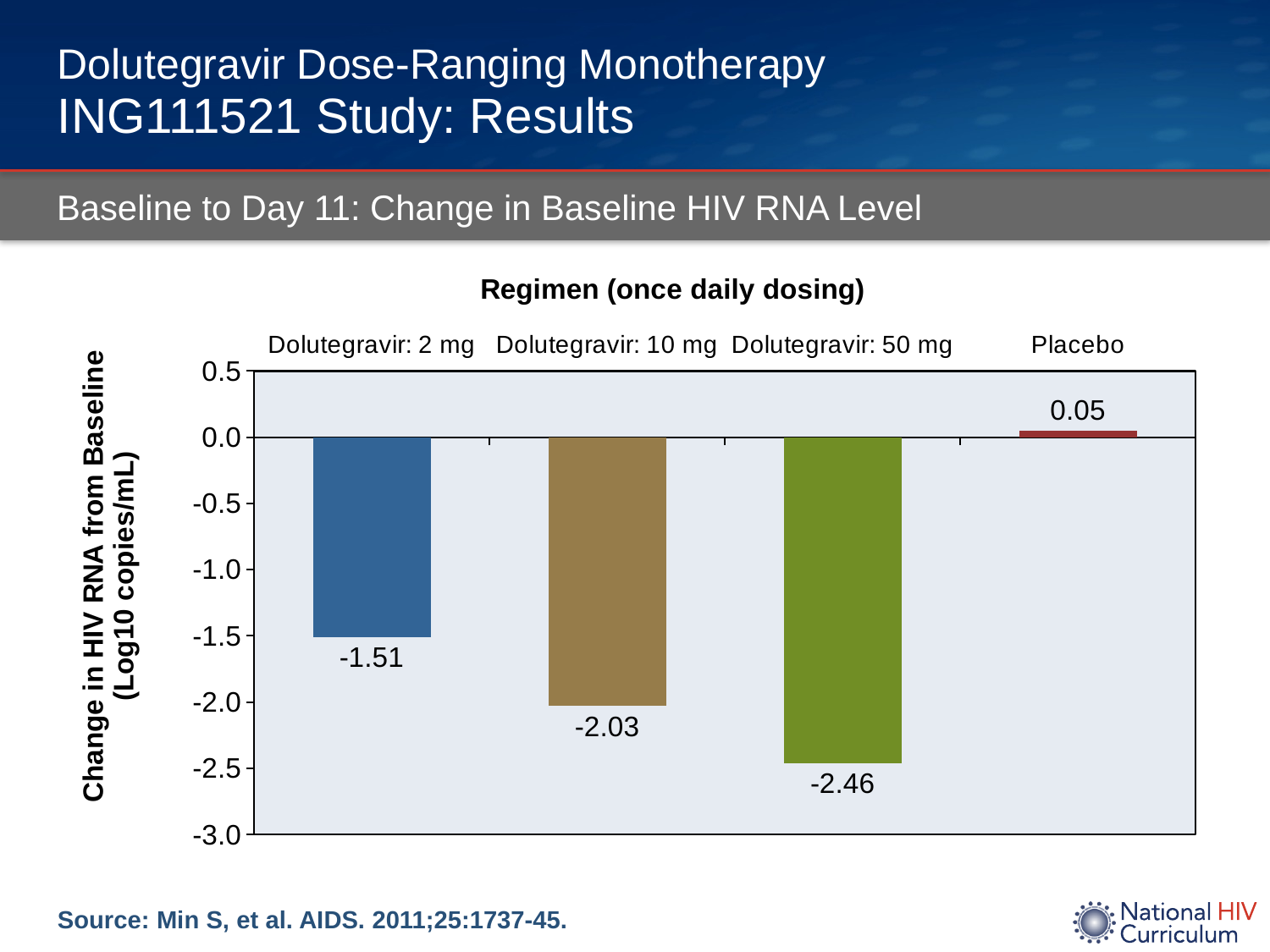
Which has a larger (less negative) value, Dolutegravir: 2 mg or Dolutegravir: 10 mg? Dolutegravir: 2 mg What is the difference between the values for Dolutegravir: 50 mg and Dolutegravir: 2 mg? 0.95 How many regimens are shown in the chart? 4 What is the change in HIV RNA from baseline for Dolutegravir: 10 mg? -2.03 What kind of chart is shown on the slide? Bar chart What is the change in HIV RNA from baseline for Dolutegravir: 50 mg? -2.46 What is the change in HIV RNA from baseline for Dolutegravir: 2 mg? -1.51 What is the label of the vertical axis of the chart? Change in HIV RNA from Baseline (Log10 copies/mL) Is the value for Dolutegravir: 10 mg greater or less than -1.5? less Which regimen has the lowest (most negative) change in HIV RNA from baseline? Dolutegravir: 50 mg What is the change in HIV RNA from baseline for Placebo? 0.05 Which regimen has the highest change in HIV RNA from baseline? Placebo